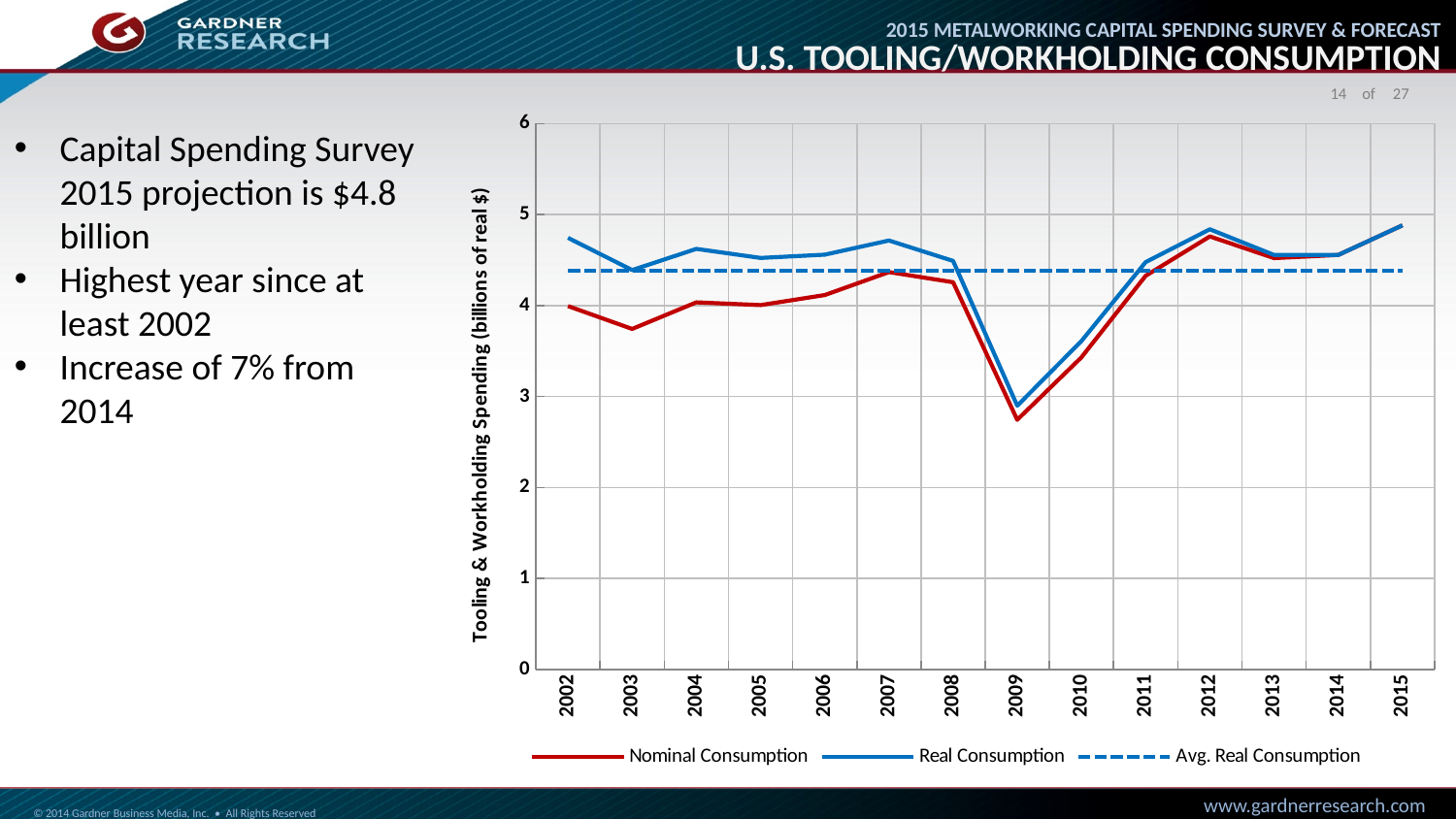
Does Nominal Consumption rise or fall from 2009 to 2012? rise How many years are plotted along the x axis of the chart? 14 In 2002, which is larger: Nominal Consumption or Real Consumption? Real Consumption Is the Nominal Consumption value for 2003 greater or less than 4? less In which year is Nominal Consumption at its lowest? 2009 What is the y-axis title of the chart? Tooling & Workholding Spending (billions of real $) What type of chart is shown on the slide? line chart In which year is Real Consumption at its lowest? 2009 Is the Avg. Real Consumption line above or below 4 on the y axis? above How many series does the chart legend list? 3 Is the Real Consumption value for 2002 greater or less than 4? greater